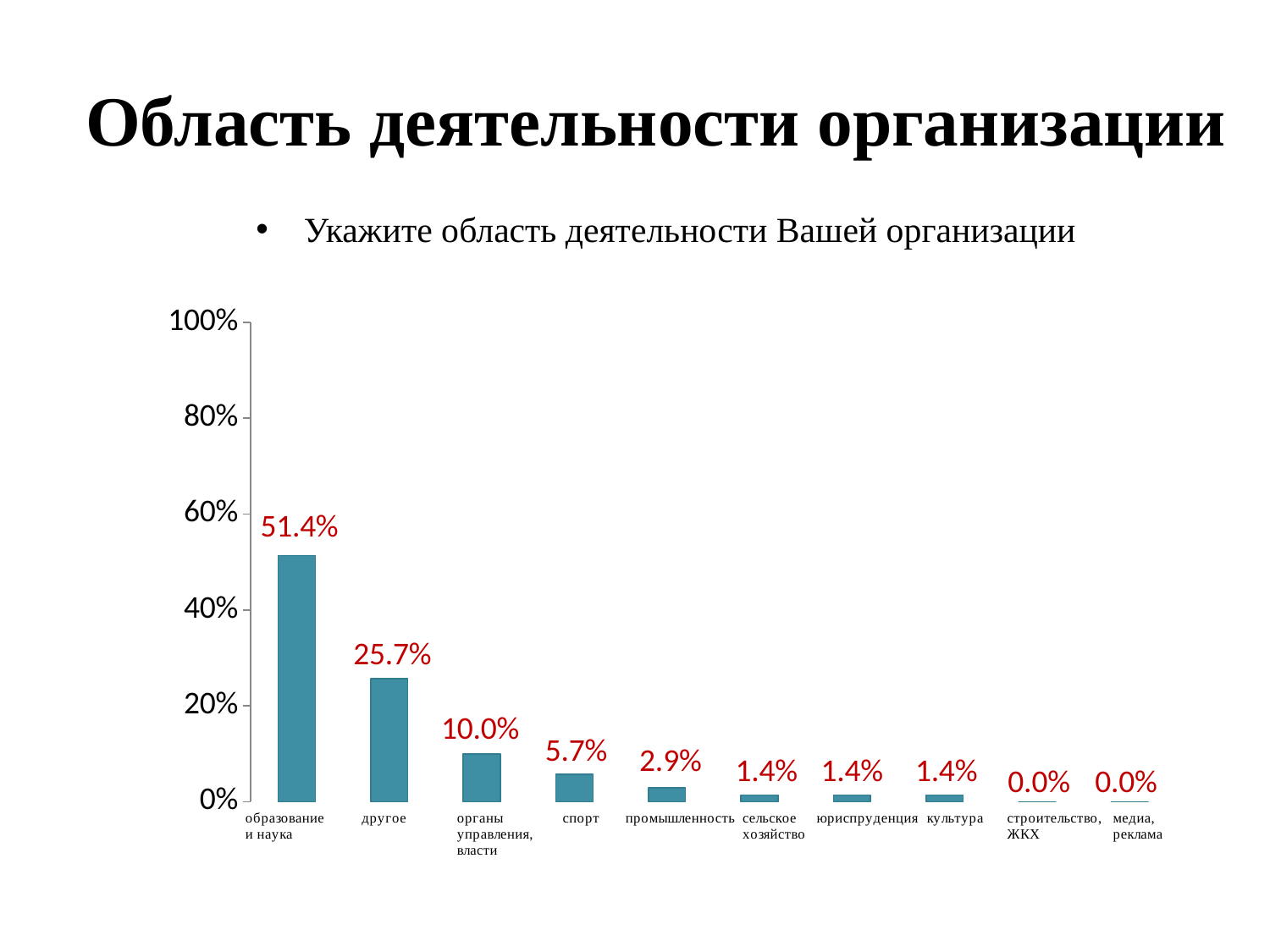
What is the value for промышленность? 2.9% What kind of chart is shown on the slide? bar chart What is the difference between the values for образование и наука and другое? 25.7% What is the value for строительство, ЖКХ? 0.0% What is the value for органы управления, власти? 10.0% How many categories are shown on the x axis? 10 Which is larger, the value for спорт or the value for промышленность? спорт Which category has the highest value? образование и наука Is the value for образование и наука greater or less than 40%? greater What is the value for образование и наука? 51.4% What is the value for другое? 25.7% What is the value for спорт? 5.7%